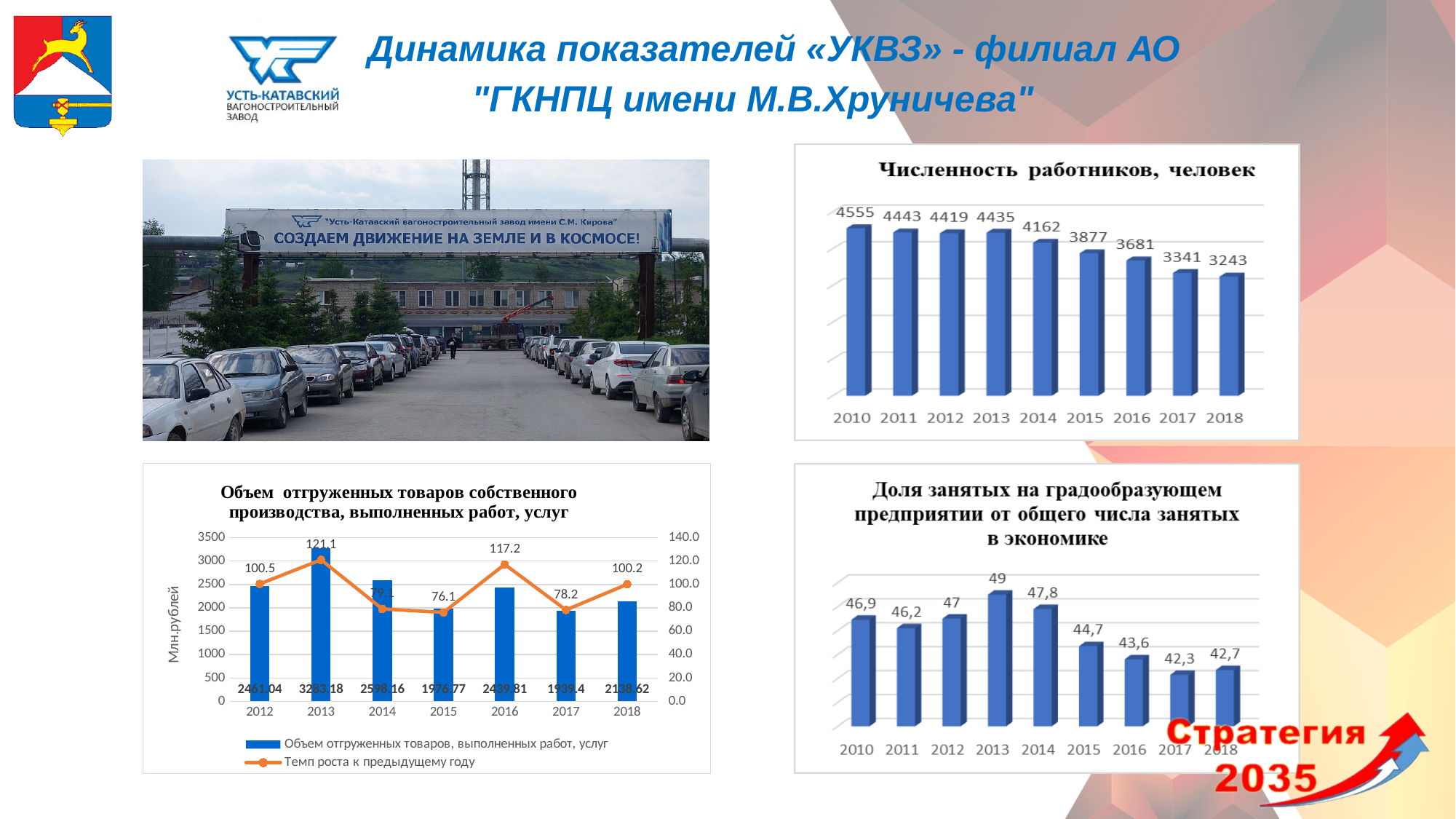
What kind of chart is 'Доля занятых на градообразующем предприятии от общего числа занятых в экономике'? bar chart In the chart 'Объем отгруженных товаров собственного производства, выполненных работ, услуг', how many series does the legend list? 2 In the chart 'Доля занятых на градообразующем предприятии от общего числа занятых в экономике', which is larger, the value for 2014 or the value for 2015? 2014 In the chart 'Численность работников, человек', how many years are shown on the x axis? 9 In the chart 'Объем отгруженных товаров собственного производства, выполненных работ, услуг', what is the bar value for 2013? 3283.18 In the chart 'Доля занятых на градообразующем предприятии от общего числа занятых в экономике', what is the value for 2013? 49 In the chart 'Объем отгруженных товаров собственного производства, выполненных работ, услуг', which year has the lowest bar value? 2017 In the chart 'Численность работников, человек', which year has the lowest value? 2018 In the chart 'Численность работников, человек', what is the difference between the values for 2010 and 2018? 1312 In the chart 'Численность работников, человек', do the values generally rise or fall from 2010 to 2018? fall In the chart 'Объем отгруженных товаров собственного производства, выполненных работ, услуг', what is the value of 'Темп роста к предыдущему году' for 2016? 117.2 In the chart 'Численность работников, человек', what is the value for 2010? 4555